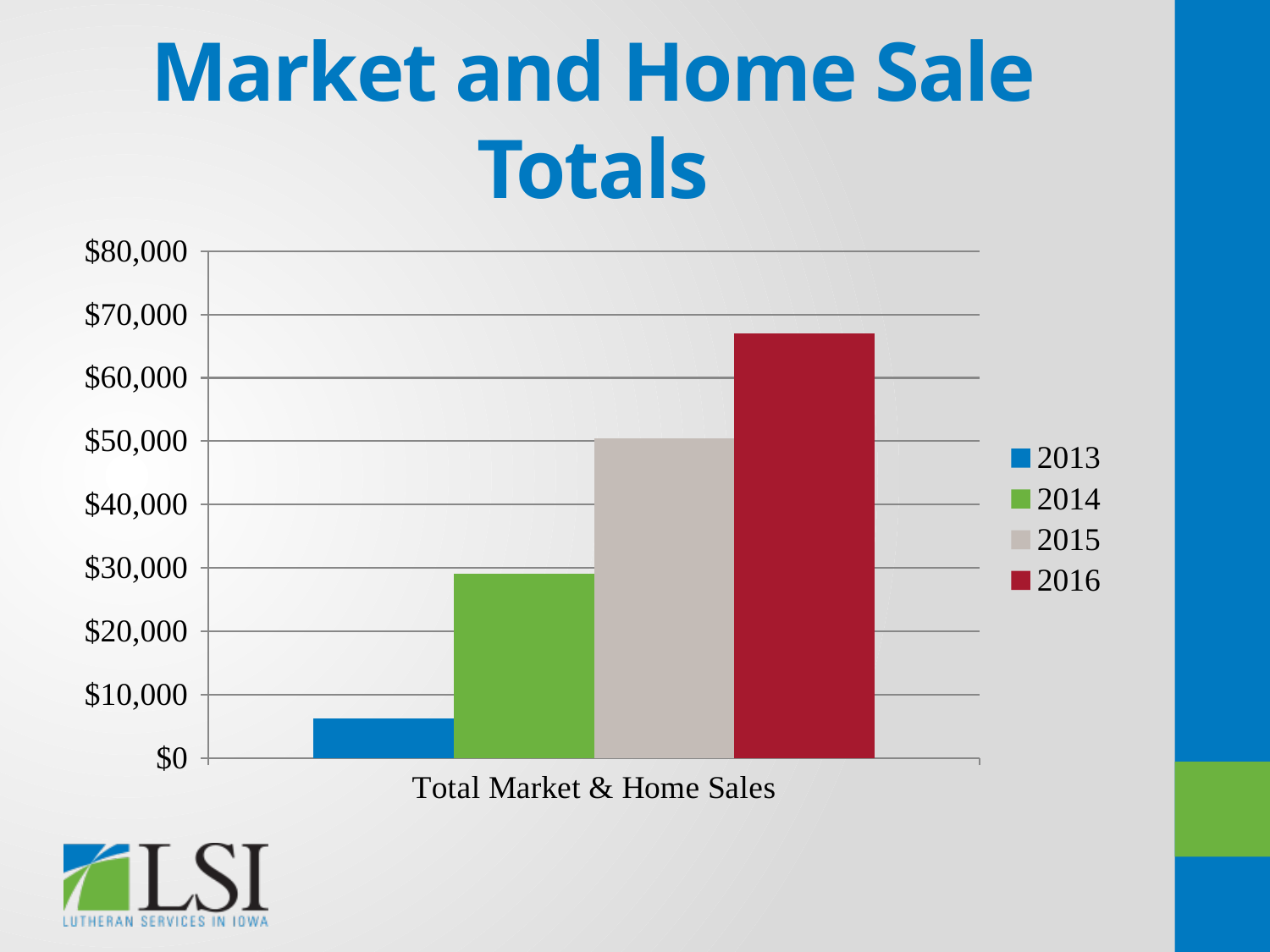
What kind of chart is shown on the slide? bar chart Is the value for 2016 greater or less than $70,000? less What is the title of the chart? Market and Home Sale Totals Do the total market and home sales rise or fall from 2013 to 2016? rise Which is larger, the value for 2014 or the value for 2015? 2015 Which year has the lowest total market and home sales? 2013 Is the value for 2014 greater or less than $20,000? greater How many series does the legend list? 4 Is the value for 2013 greater or less than $10,000? less What colour is the bar for 2016? red How many categories are shown on the x axis? 1 Which year has the highest total market and home sales? 2016